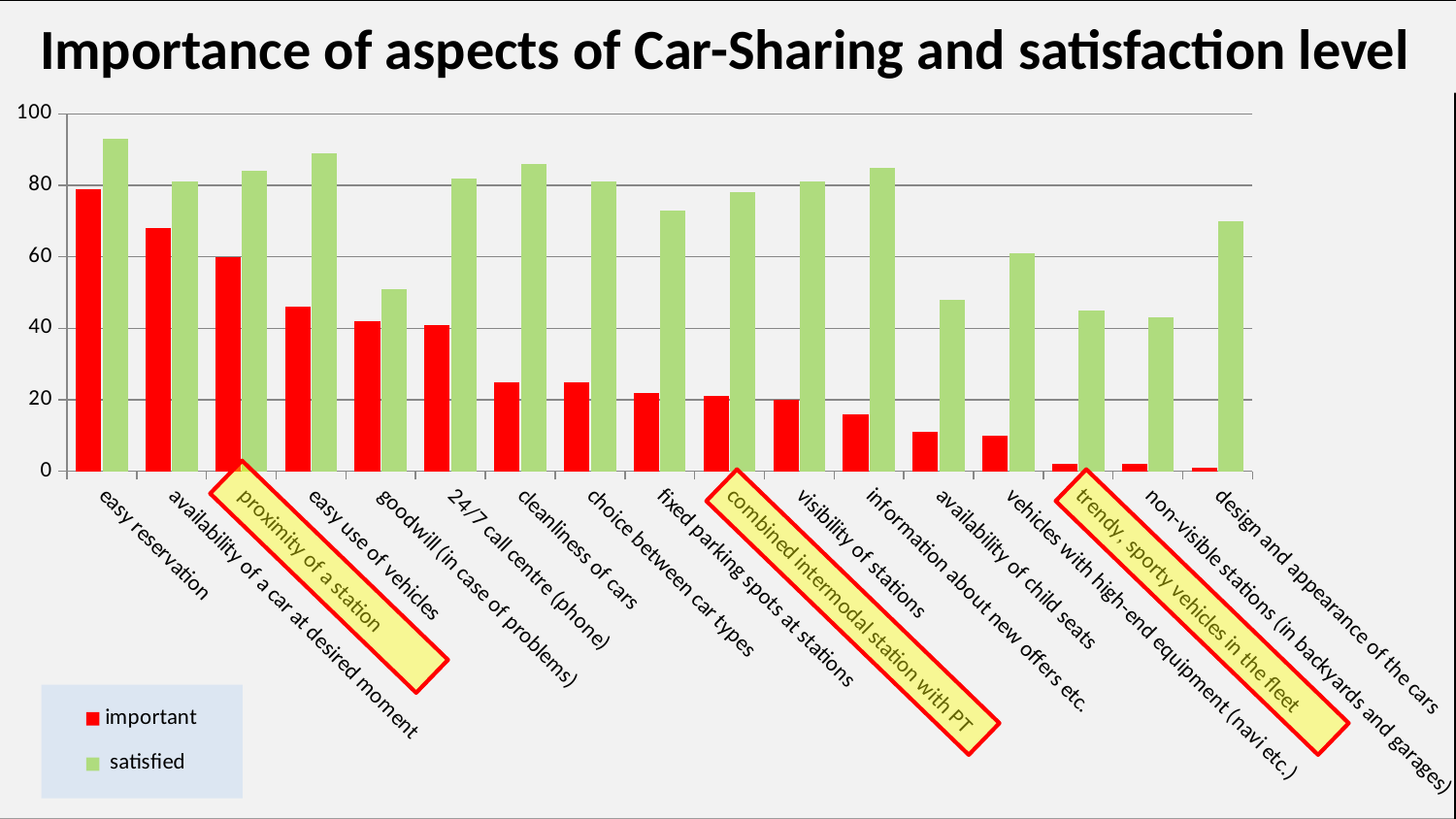
Which aspect has the highest 'important' value? easy reservation Is the 'important' value for easy reservation greater or less than 60? greater Which aspect has the lowest 'important' value? design and appearance of the cars What colour are the bars for the 'satisfied' series? green Is the 'satisfied' value for goodwill (in case of problems) greater or less than 40? greater What kind of chart is shown on the slide? bar chart How many aspects (categories) are plotted on the x axis? 17 For easy reservation, which is larger: the 'important' value or the 'satisfied' value? satisfied How many series does the legend list? 2 Do the 'important' values rise or fall moving left to right along the x axis? fall Which has the larger 'important' value: easy reservation or availability of a car at desired moment? easy reservation Is the 'satisfied' value for availability of child seats greater or less than 60? less